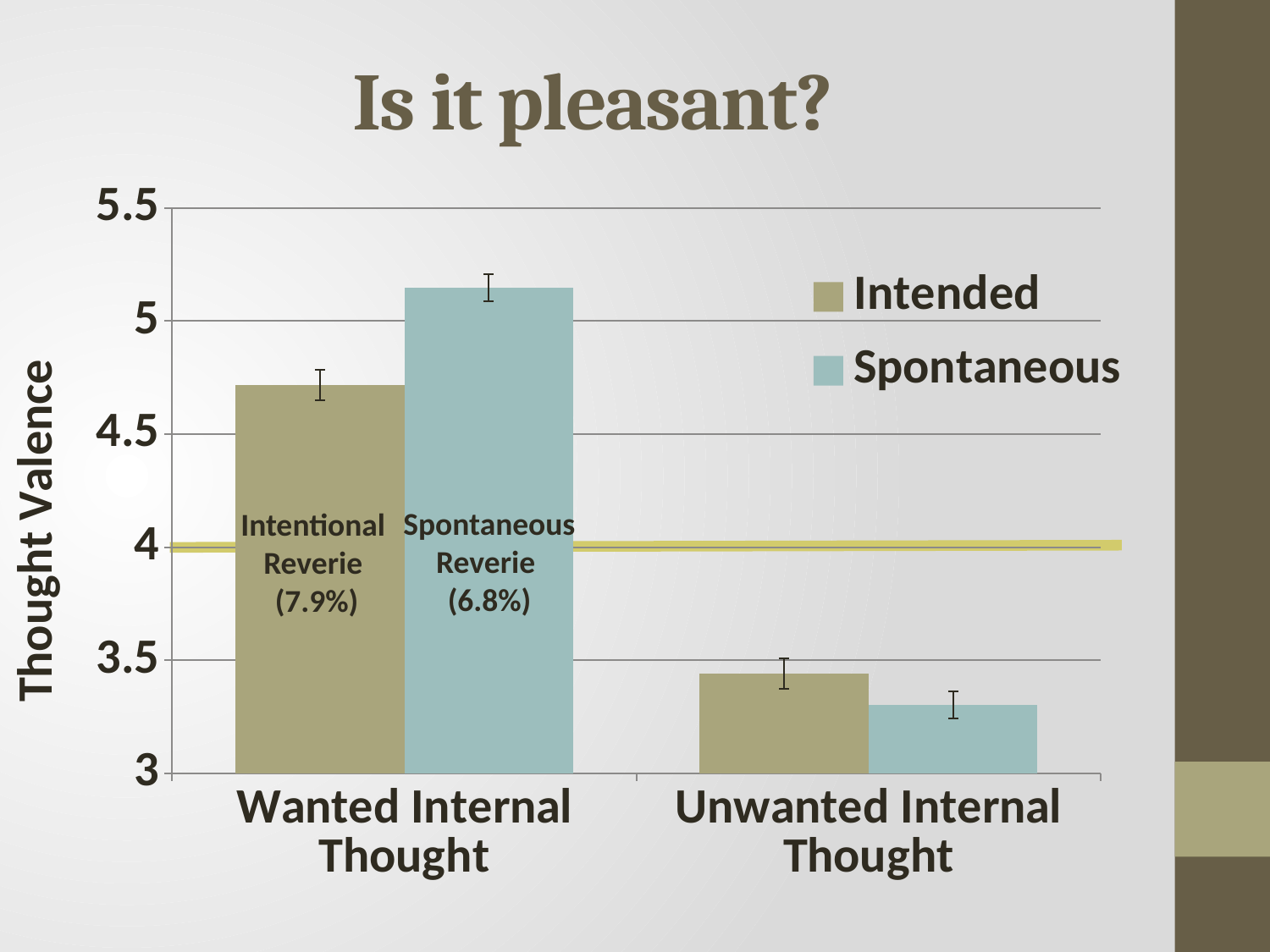
For Unwanted Internal Thought, which series has the larger value, Intended or Spontaneous? Intended How many series does the legend list? 2 Which bar is the lowest in the chart? Spontaneous, Unwanted Internal Thought Do the Intended values rise or fall from Wanted Internal Thought to Unwanted Internal Thought? fall What is the label on the vertical axis of the chart? Thought Valence Is the Intended value for Wanted Internal Thought greater or less than 4.5? greater Is the Intended value for Unwanted Internal Thought greater or less than 3.5? less For Wanted Internal Thought, which series has the larger value, Intended or Spontaneous? Spontaneous Is the Spontaneous value for Wanted Internal Thought greater or less than 5? greater Which bar is the highest in the chart? Spontaneous, Wanted Internal Thought What kind of chart is shown on the slide? bar chart How many categories are shown on the x axis? 2